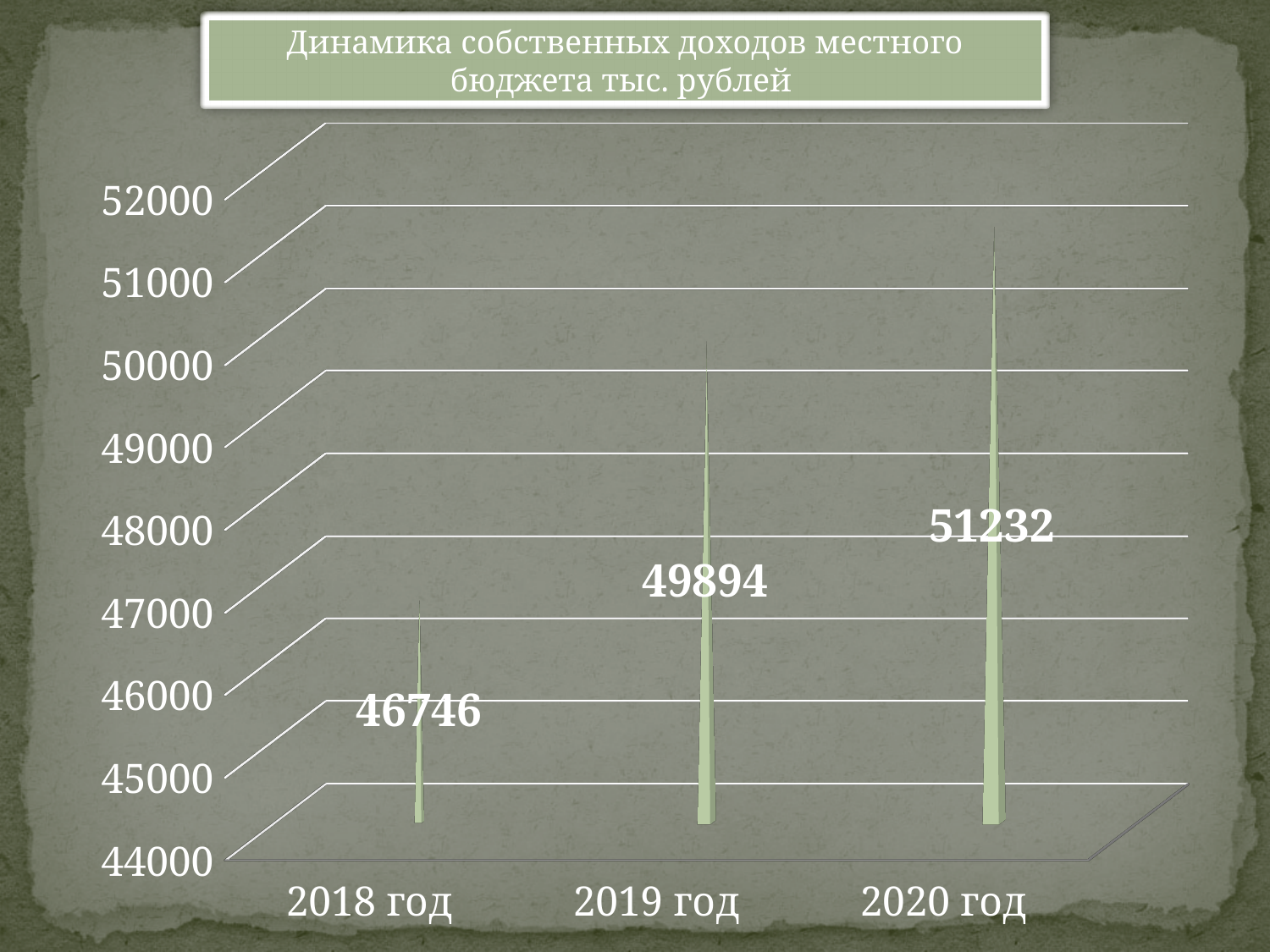
What is the difference between the values for 2019 год and 2018 год? 3148 What is the title of the chart? Динамика собственных доходов местного бюджета тыс. рублей What is the value for 2019 год? 49894 Which is larger, the value for 2019 год or the value for 2020 год? 2020 год What is the value for 2018 год? 46746 Which year has the highest value? 2020 год Which year has the lowest value? 2018 год What is the value for 2020 год? 51232 Do the values rise or fall from 2018 год to 2020 год? rise What is the difference between the values for 2020 год and 2018 год? 4486 Is the value for 2018 год greater or less than 47000? less How many years are shown on the x axis? 3